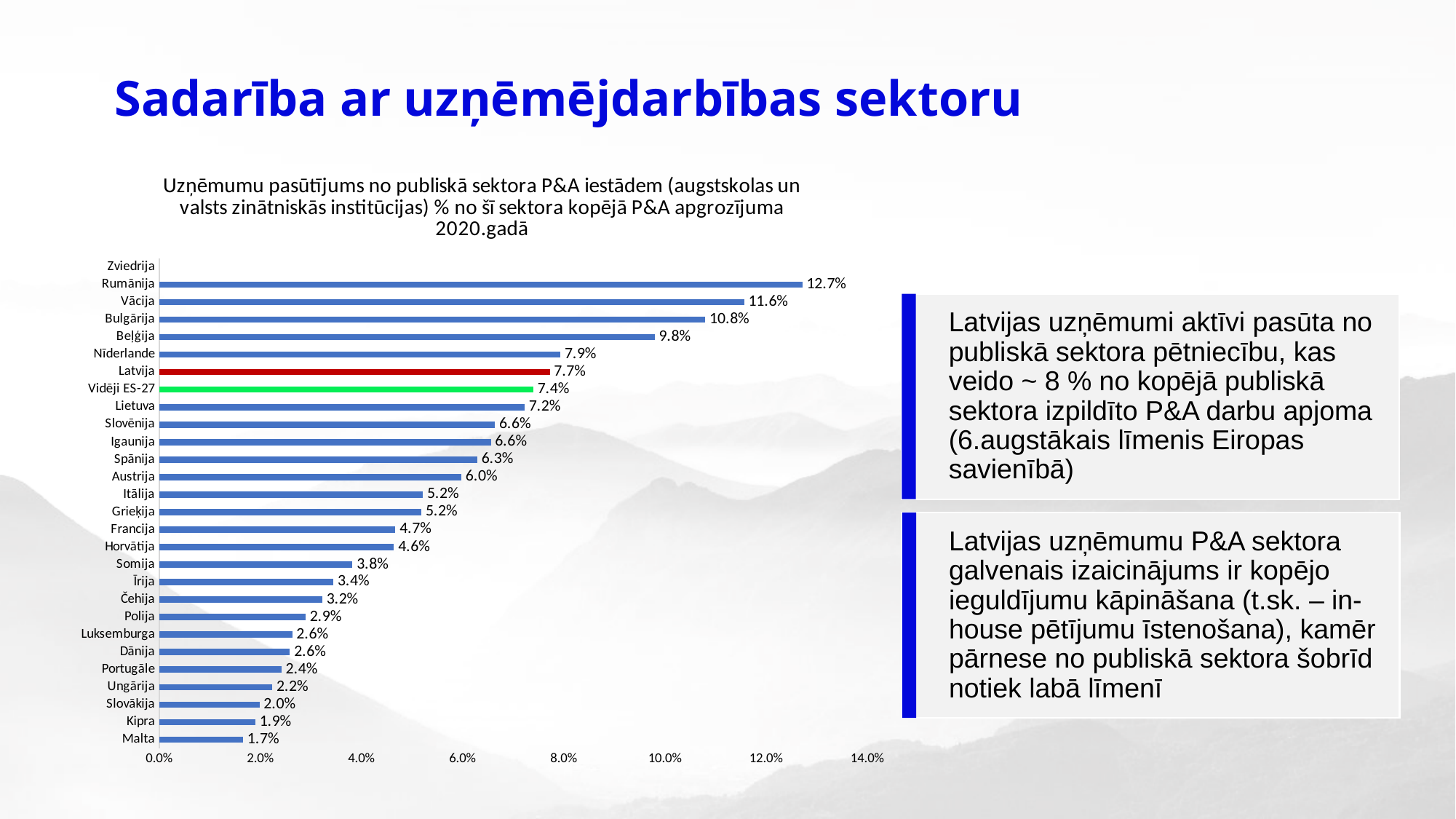
What kind of chart is shown on the slide? bar chart What is the value for Rumānija? 12.7% What is the value for Latvija? 7.7% What is the difference between the values for Rumānija and Vācija? 1.1% What is the value for Vidēji ES-27? 7.4% What colour is the bar for Latvija? red Is the value for Beļģija greater or less than 10.0%? less Which country has the lowest value? Malta Which country has the highest plotted value? Rumānija Which is larger, the value for Vācija or the value for Bulgārija? Vācija What is the value for Malta? 1.7% What is the difference between the values for Latvija and Vidēji ES-27? 0.3%